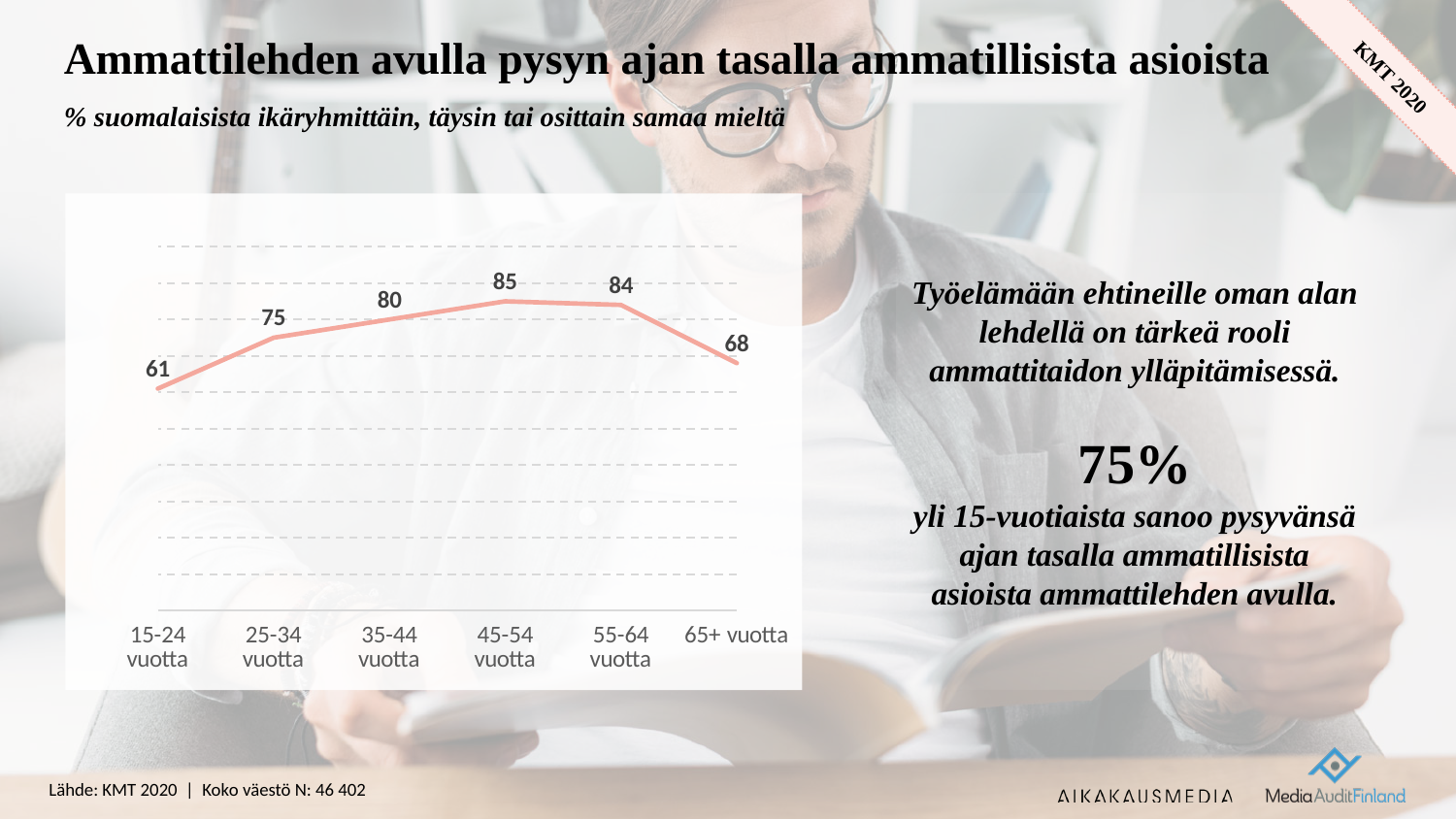
What kind of chart is shown on the slide? Line chart What is the difference between the values for 45-54 vuotta and 15-24 vuotta? 24 Do the values rise or fall from the 45-54 vuotta group to the 65+ vuotta group? Fall Which age group has a higher value, 25-34 vuotta or 65+ vuotta? 25-34 vuotta What is the value shown for the 45-54 vuotta age group? 85 Which age group has the highest value in the chart? 45-54 vuotta How many age groups are plotted in the chart? 6 Which age group has the lowest value in the chart? 15-24 vuotta What is the value shown for the 35-44 vuotta age group? 80 What is the difference between the values for 55-64 vuotta and 65+ vuotta? 16 What is the value shown for the 65+ vuotta age group? 68 What percentage of 15-24 year olds agree that a professional magazine keeps them up to date on professional matters? 61